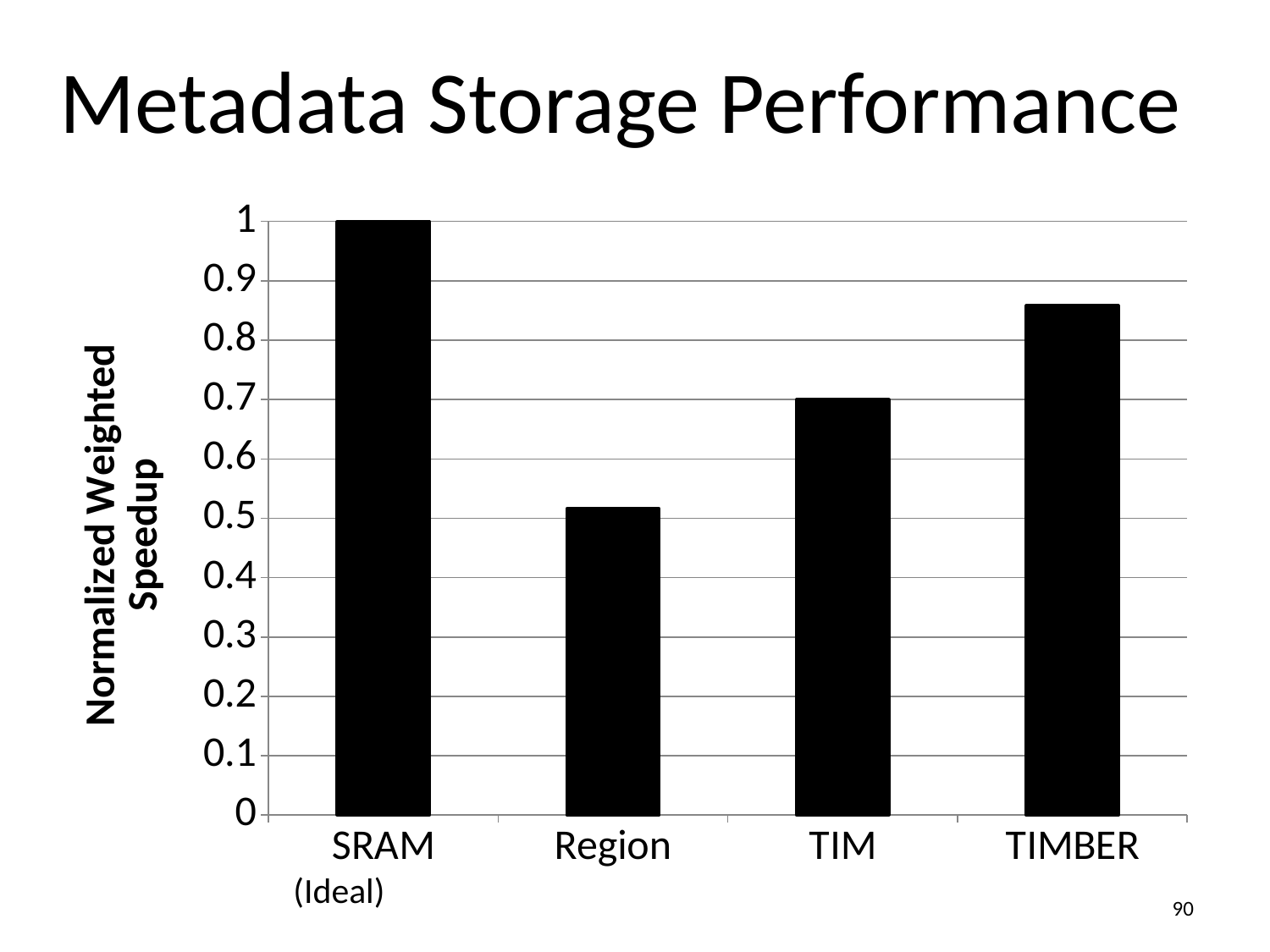
Is the value for Region greater or less than 0.6? less Is the value for TIM greater or less than 0.6? greater Is the value for TIMBER greater or less than 0.8? greater Which has a higher normalized weighted speedup, TIM or TIMBER? TIMBER How many categories are plotted on the x axis? 4 What is the label of the y axis? Normalized Weighted Speedup Which category has the lowest normalized weighted speedup? Region Which category has the highest normalized weighted speedup? SRAM (Ideal) What kind of chart is shown on the slide? bar chart What is the title of the slide containing the chart? Metadata Storage Performance Which has a higher normalized weighted speedup, Region or TIM? TIM What is the normalized weighted speedup for SRAM (Ideal)? 1